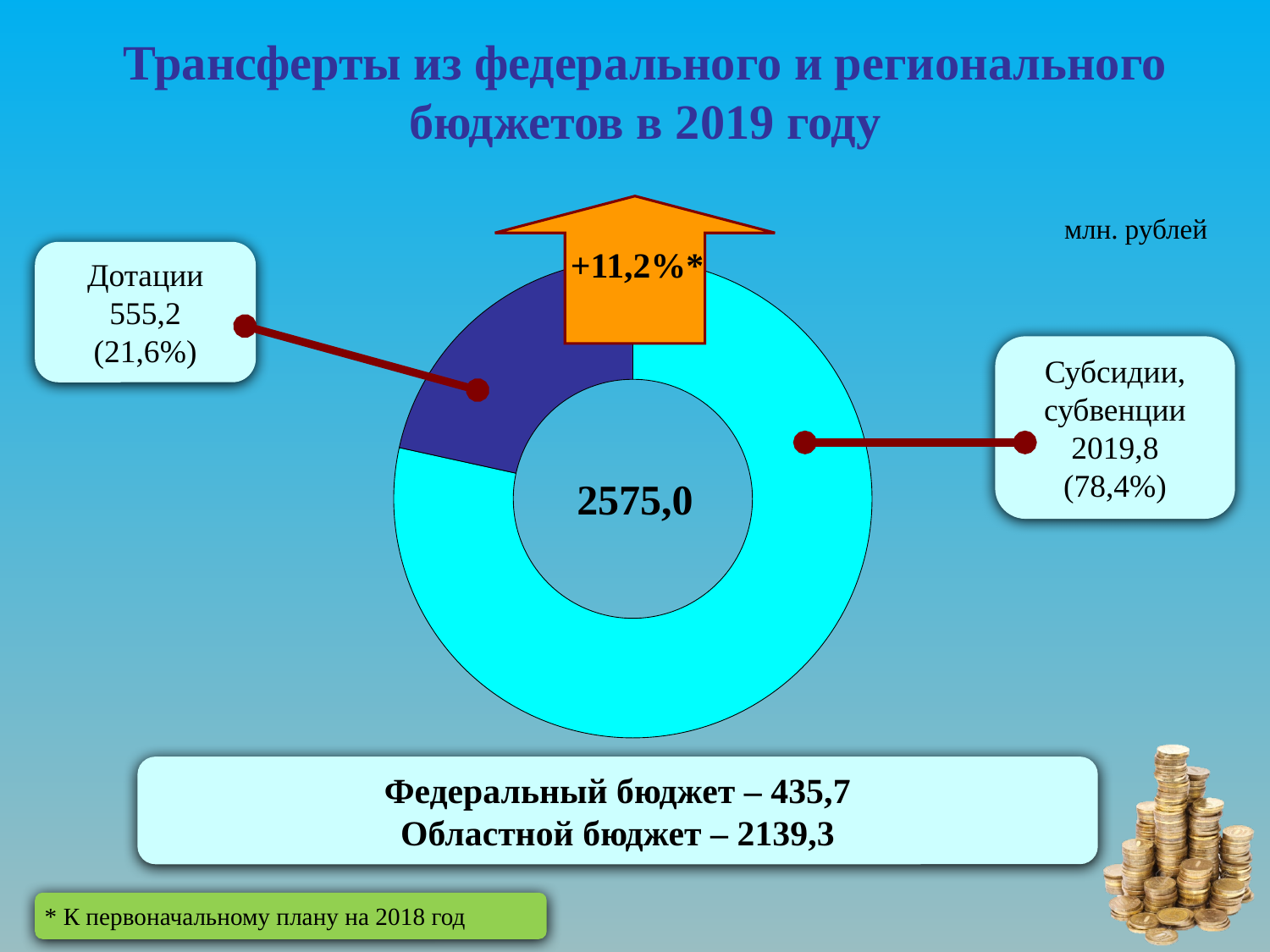
What kind of chart is shown on the slide? Doughnut (pie) chart How many slices does the chart have? 2 Which is larger, Дотации or Субсидии, субвенции? Субсидии, субвенции What is the value for Дотации? 555,2 What is the difference between Субсидии, субвенции and Дотации? 1464,6 What is the value for Субсидии, субвенции? 2019,8 What colour is the Дотации slice? Dark blue Which category has the largest slice? Субсидии, субвенции What total value is shown in the centre of the chart? 2575,0 What share of the chart does Дотации represent? 21,6% Which category has the smallest slice? Дотации What share of the chart does Субсидии, субвенции represent? 78,4%